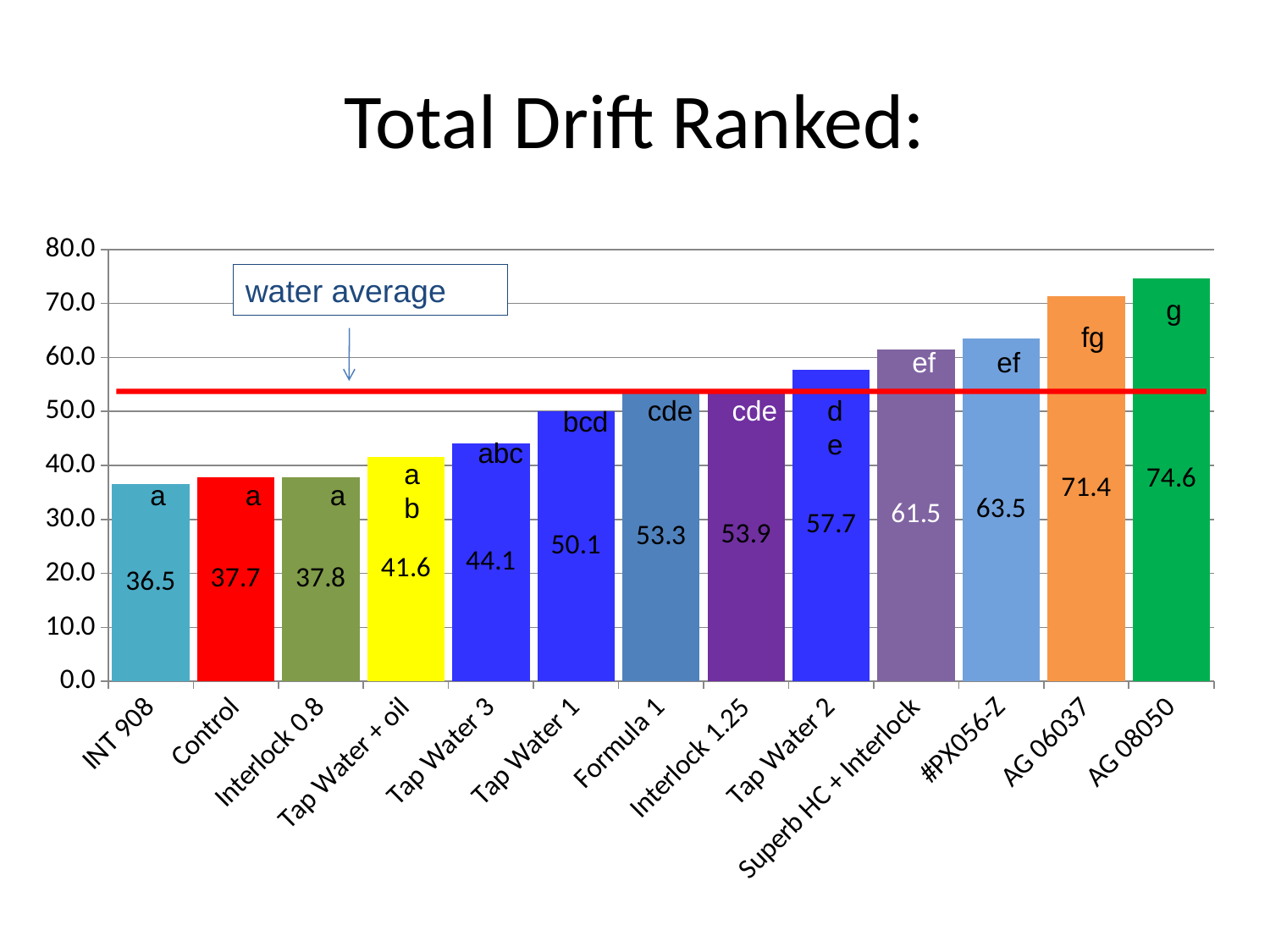
Which is larger, the value for Formula 1 or the value for Tap Water + oil? Formula 1 What is the difference between the values for AG 08050 and INT 908? 38.1 Which category has the lowest value? INT 908 What is the value for Tap Water 3? 44.1 What does the red horizontal line on the chart represent? water average What kind of chart is shown on the slide? bar chart How many categories are shown on the x axis? 13 Is the value for #PX056-Z greater or less than 60.0? greater What is the value for Superb HC + Interlock? 61.5 What is the value for AG 06037? 71.4 Which category has the highest value? AG 08050 What is the difference between the values for Tap Water 2 and Tap Water 1? 7.6